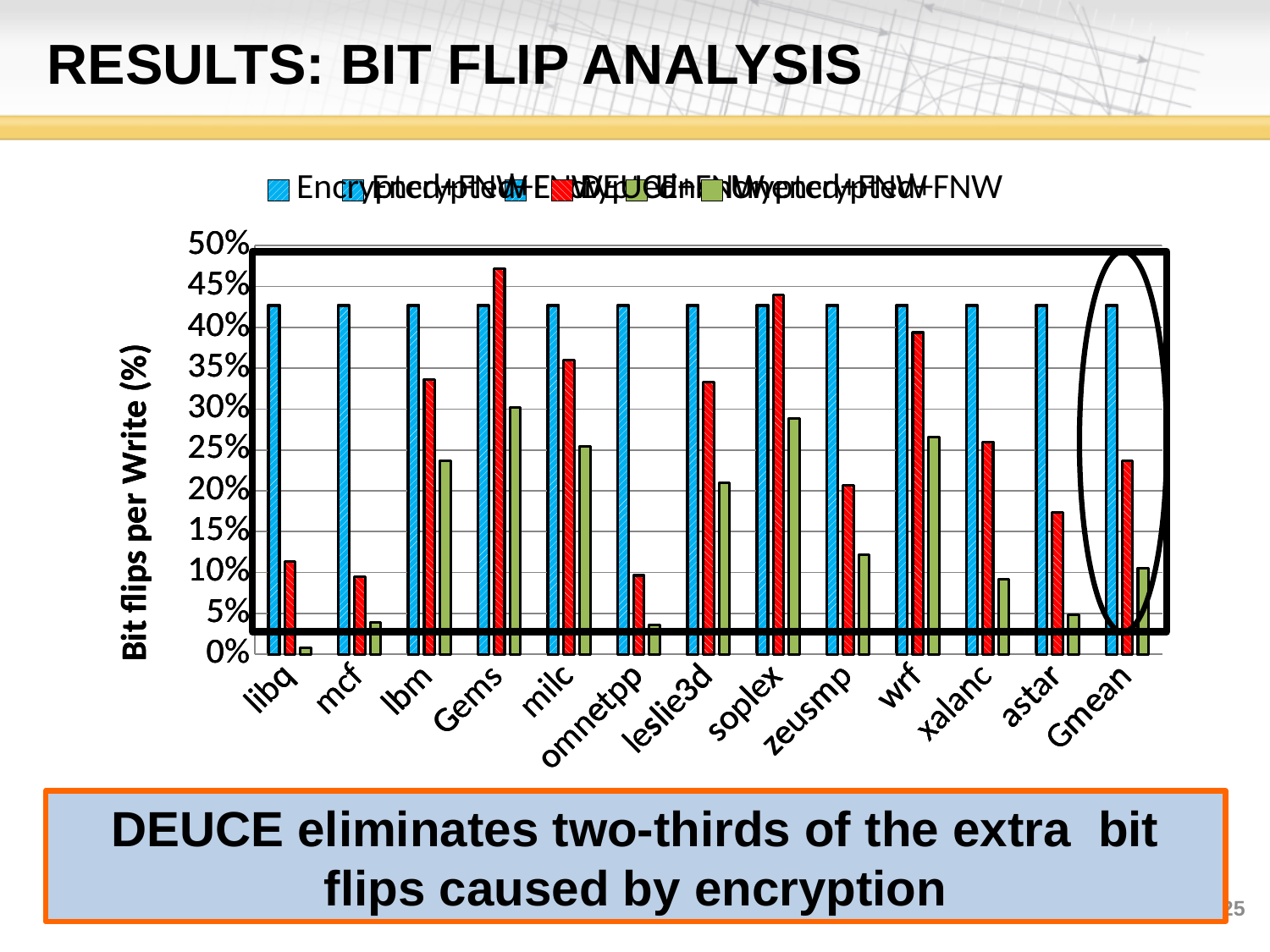
Which is larger, the red bar for lbm or the red bar for mcf? lbm Which category has the lowest green bar? libq Is the value of the red bar for libq greater or less than 15%? less Is the value of the green bar for Gems greater or less than 25%? greater Is the value of the blue bar for libq greater or less than 40%? greater Which category is circled on the chart? Gmean Which category has the highest red bar? Gems What kind of chart is shown on the slide? bar chart What is the title of the y axis of the chart? Bit flips per Write (%) How many categories are shown along the x axis of the chart? 13